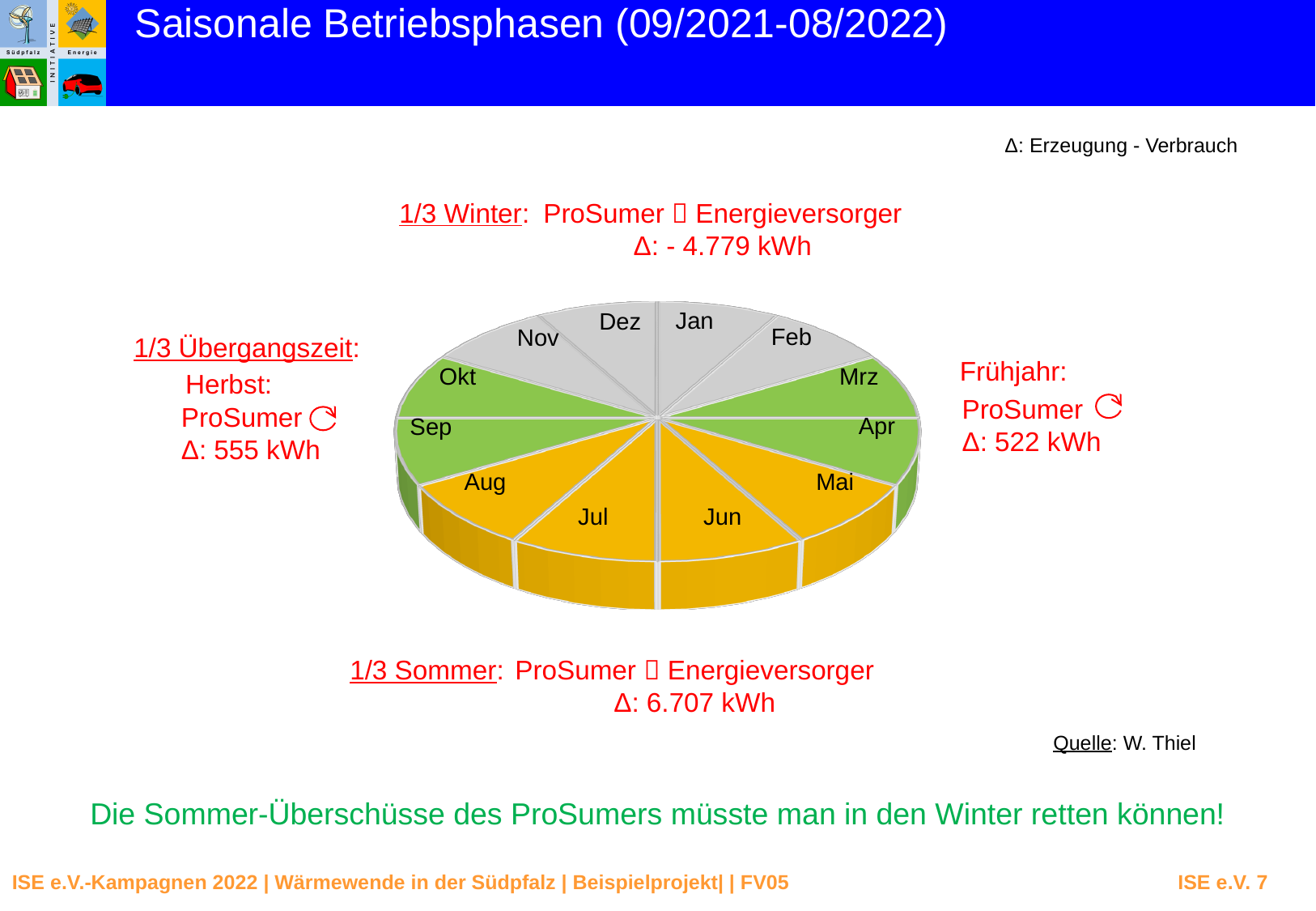
What is the Δ value given for Frühjahr? 522 kWh What kind of chart is shown on the slide? pie chart Which phase has the lowest Δ value on the slide? Winter How many slices does the pie chart have? 12 What is the Δ value given for Herbst? 555 kWh What is the difference between the Δ values for Herbst and Frühjahr? 33 kWh What colour is the slice for Jul on the pie chart? yellow Which has the larger Δ value, Herbst or Frühjahr? Herbst What is the Δ value given for the Winter phase? - 4.779 kWh What is the Δ value given for the Sommer phase? 6.707 kWh Which phase has the highest Δ value on the slide? Sommer Which months are shown in grey on the pie chart? Nov, Dez, Jan, Feb